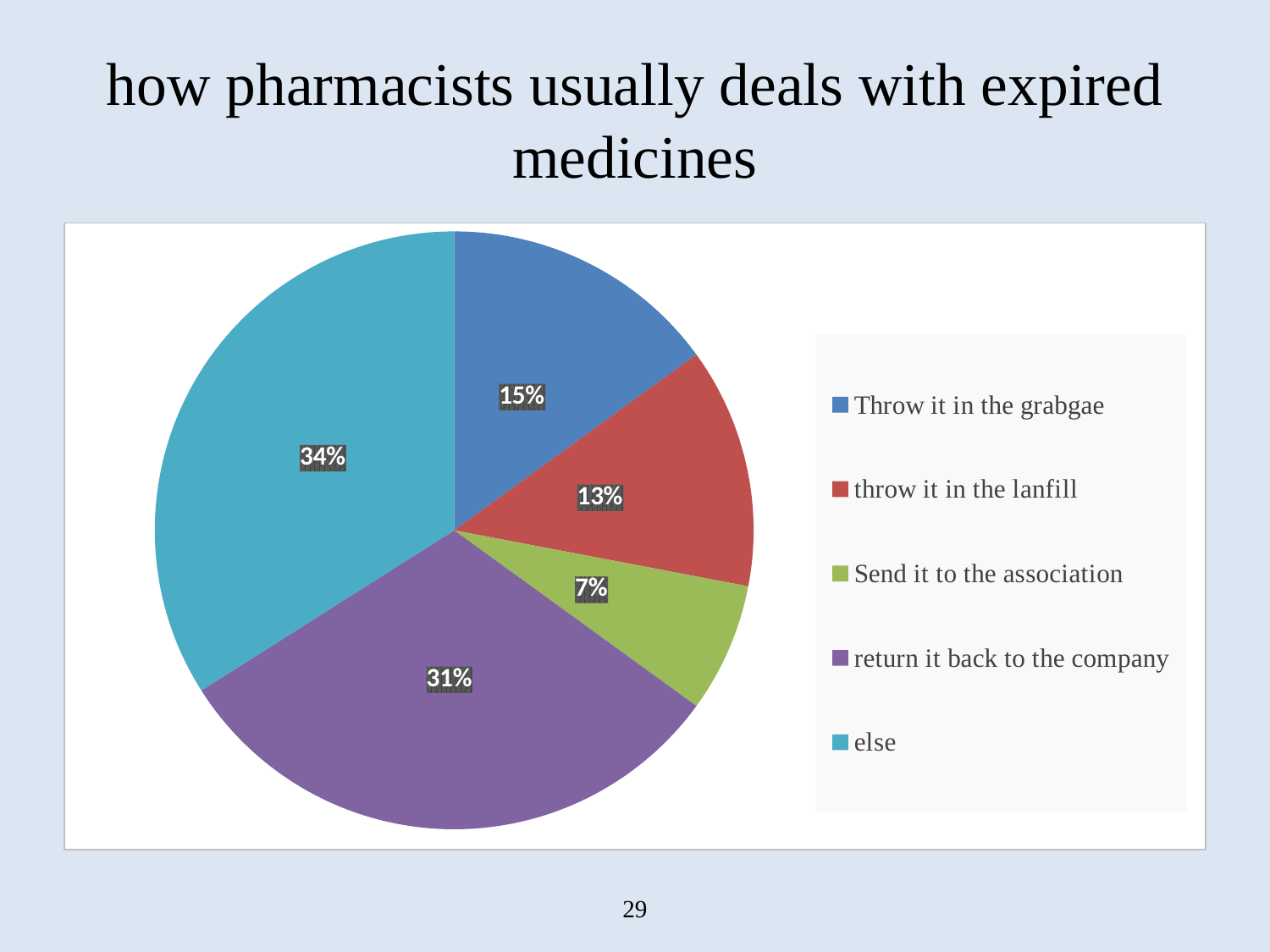
What type of chart is shown on the slide? Pie chart Which category has the largest share of the pie? else What percentage corresponds to "Send it to the association"? 7% What is the difference in percentage points between "else" and "return it back to the company"? 3 What percentage of pharmacists throw expired medicines in the garbage ("Throw it in the grabgae")? 15% What share of the pie is labelled "throw it in the lanfill"? 13% How many categories does the pie chart show? 5 What percentage of pharmacists "return it back to the company"? 31% What is the value of the "else" slice? 34% Which is larger: "Throw it in the grabgae" or "throw it in the lanfill"? Throw it in the grabgae What colour is the "return it back to the company" slice? Purple Which category has the smallest share of the pie? Send it to the association